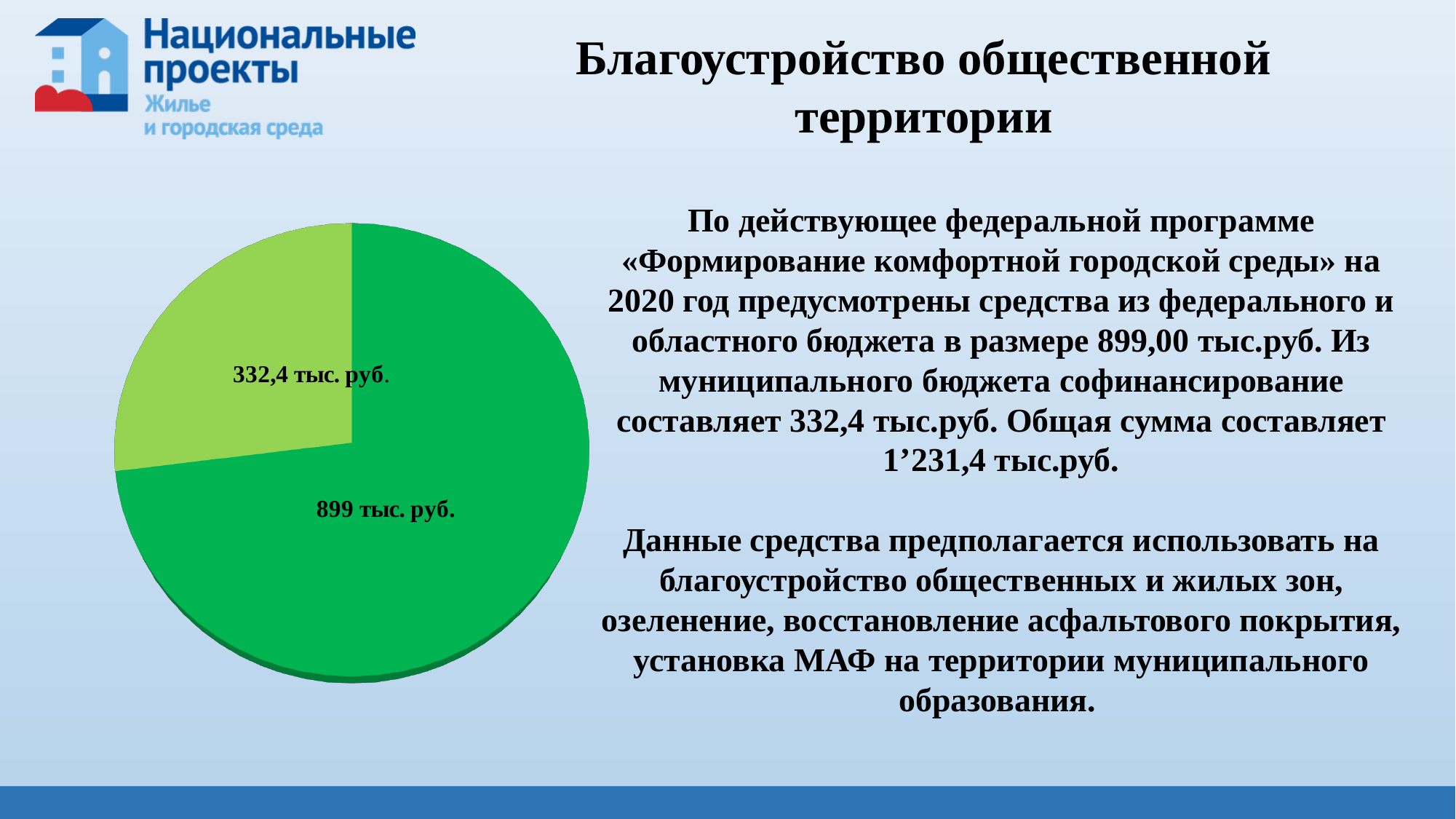
What value is labelled on the dark green slice of the pie chart? 899 тыс. руб. Which is larger in the pie chart, the dark green slice or the light green slice? The dark green slice What is the total of the two slices in the pie chart? 1’231,4 тыс. руб. Which slice of the pie chart has the smallest value? 332,4 тыс. руб. (light green) Which slice of the pie chart has the largest value? 899 тыс. руб. (dark green) What is the difference between the two slice values in the pie chart? 566,6 тыс. руб. What kind of chart is shown on the slide? Pie chart Does the pie chart have a legend? No What value is labelled on the light green slice of the pie chart? 332,4 тыс. руб. How many slices does the pie chart have? 2